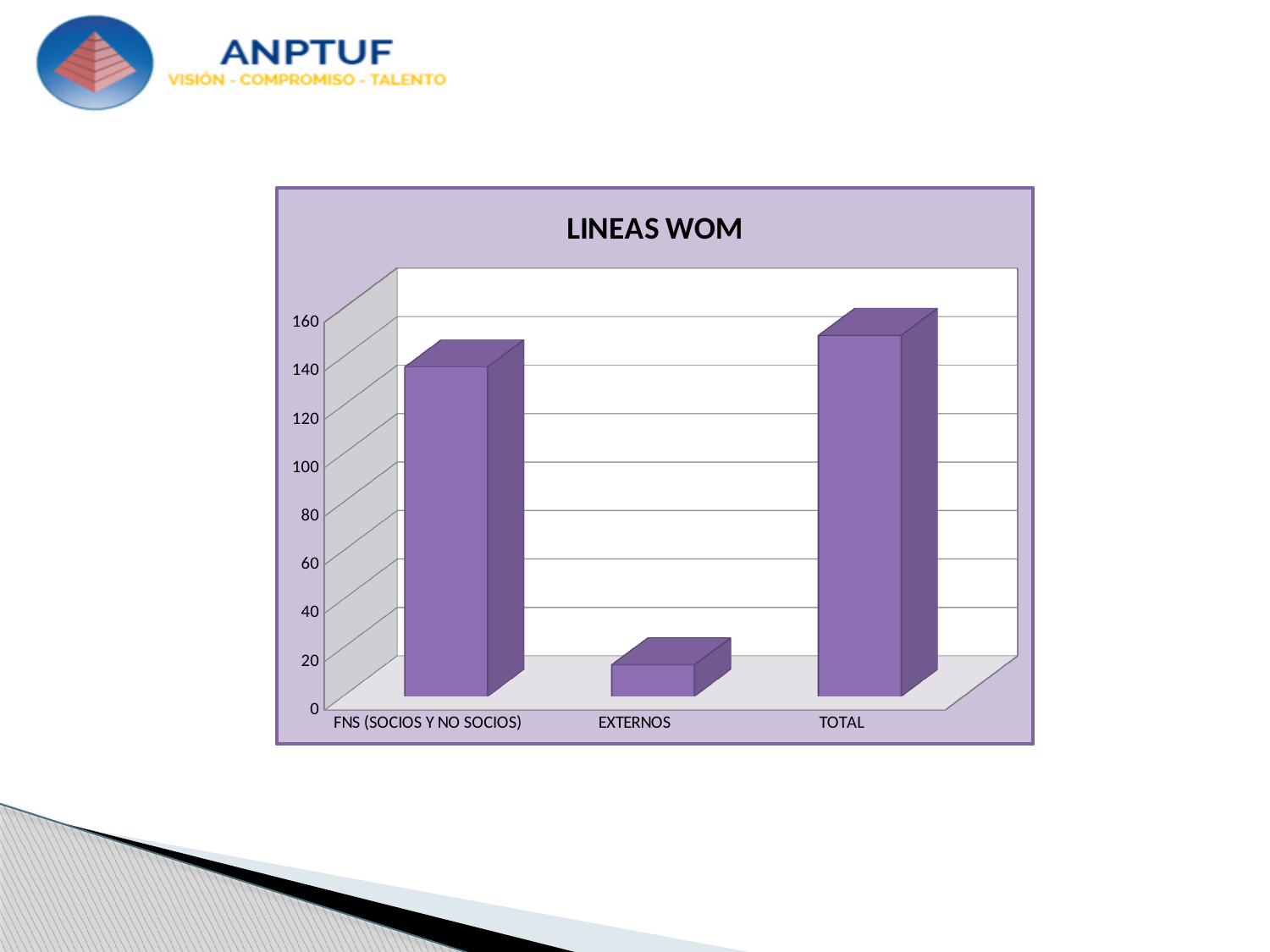
What kind of chart is shown on the slide? bar chart Which is larger, the value for TOTAL or the value for FNS (SOCIOS Y NO SOCIOS)? TOTAL What is the highest value labelled on the vertical axis of the chart? 160 Which is larger, the value for FNS (SOCIOS Y NO SOCIOS) or the value for EXTERNOS? FNS (SOCIOS Y NO SOCIOS) Which category has the highest value in the chart? TOTAL Is the value for FNS (SOCIOS Y NO SOCIOS) greater or less than 120? greater What is the title of the chart? LINEAS WOM Which category has the lowest value in the chart? EXTERNOS Is the value for TOTAL greater or less than 140? greater Is the value for EXTERNOS greater or less than 40? less How many categories are shown on the x axis of the chart? 3